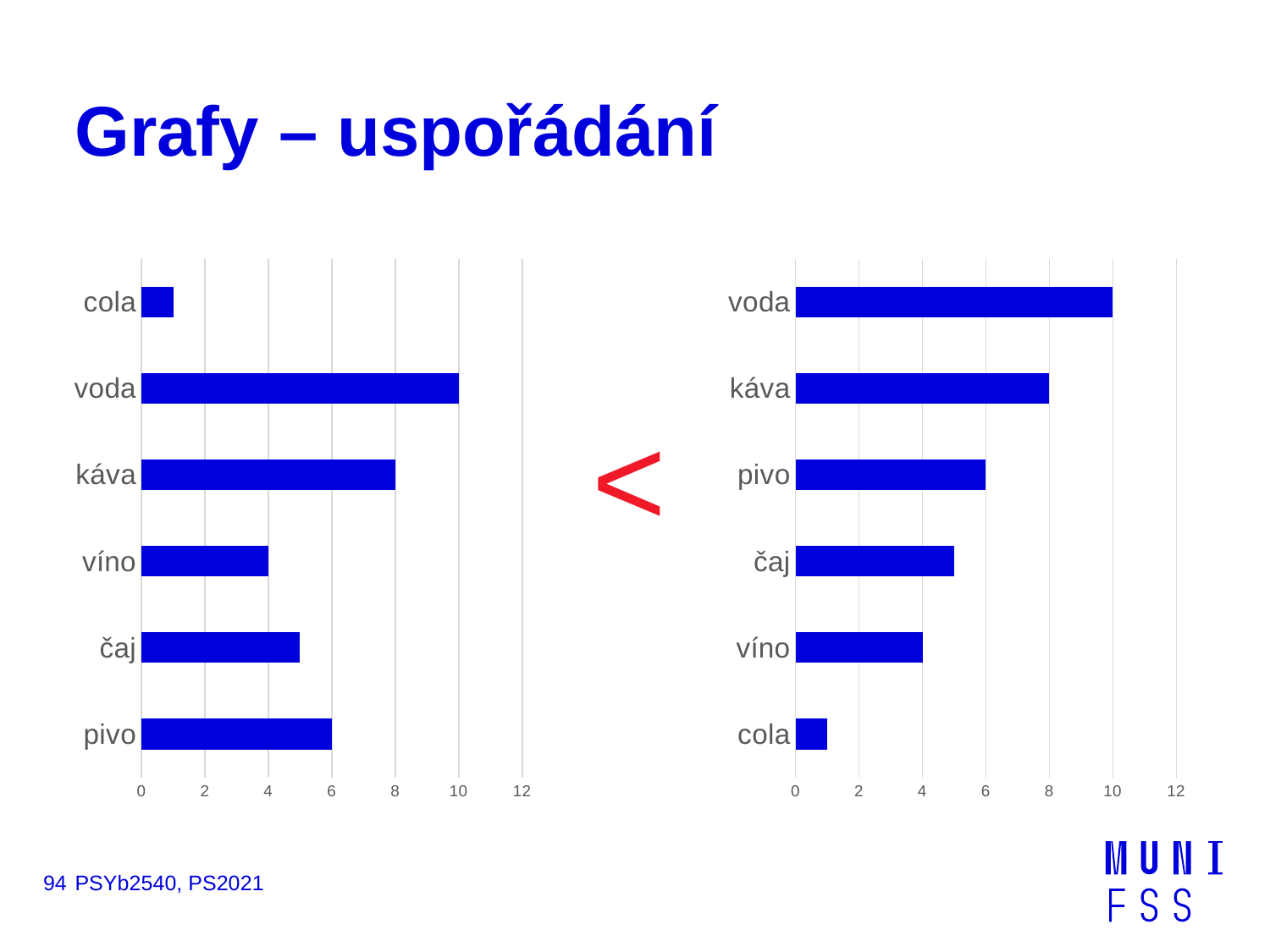
In the left chart, what is the difference between the values for voda and káva? 2 In the right chart, what is the value for káva? 8 In the right chart, which is larger, the value for pivo or the value for víno? pivo In the left chart, is the value for čaj greater or less than 4? greater In the left chart, what is the value for pivo? 6 In the right chart, which category has the lowest value? cola In the left chart, which category has the highest value? voda In the right chart, is the value for cola greater or less than 2? less In the right chart, what is the value for víno? 4 How many categories does the right chart show? 6 In the left chart, what is the value for voda? 10 What kind of chart is the left chart? bar chart